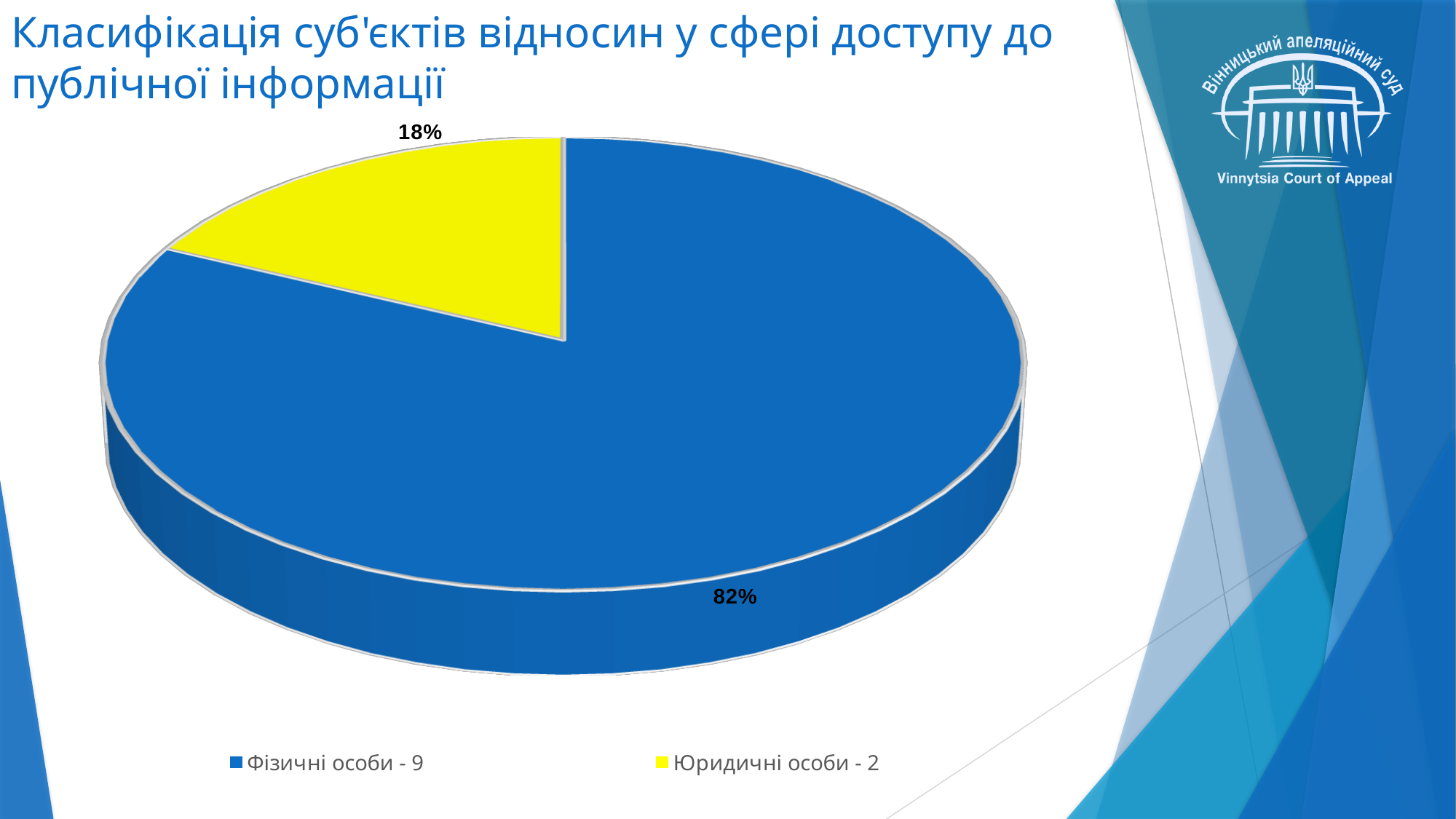
What count is shown in the legend for Фізичні особи? 9 What colour is the slice for Юридичні особи? Yellow What count is shown in the legend for Юридичні особи? 2 Which slice is larger, Фізичні особи or Юридичні особи? Фізичні особи What percentage of the pie does the slice for Юридичні особи represent? 18% What kind of chart is shown on the slide? Pie chart What is the difference in percentage points between the Фізичні особи slice and the Юридичні особи slice? 64 Which category has the smallest slice of the pie? Юридичні особи How many entries does the legend list? 2 How many slices does the pie chart have? 2 Which category has the largest slice of the pie? Фізичні особи What percentage of the pie does the slice for Фізичні особи represent? 82%